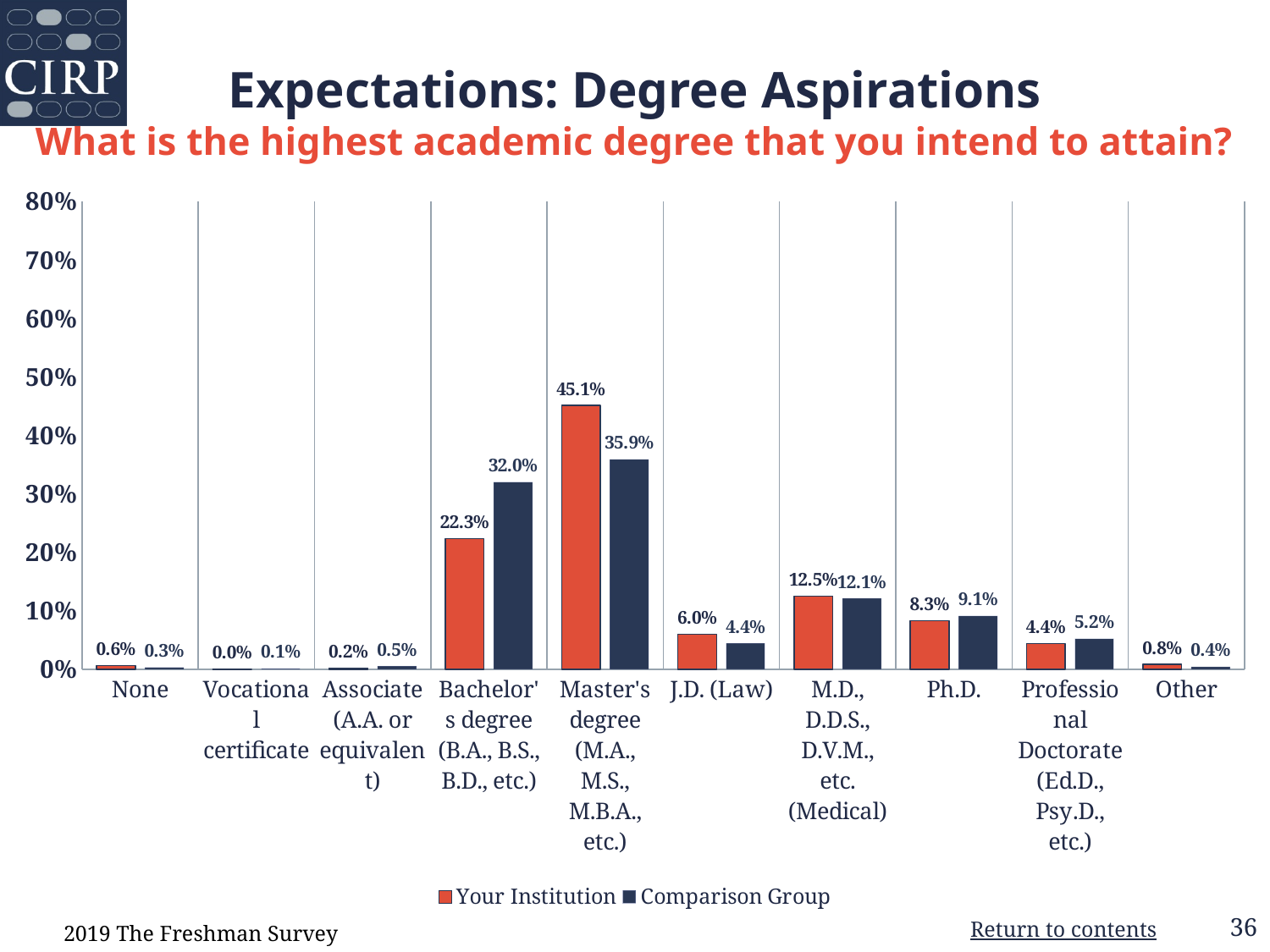
Which is larger for J.D. (Law): Your Institution or Comparison Group? Your Institution How many categories are shown on the x axis? 10 How many series does the legend list? 2 What kind of chart is shown on the slide? Bar chart Which is larger for Professional Doctorate: Your Institution or Comparison Group? Comparison Group What is the value for Your Institution for Master's degree? 45.1% What is the difference between Comparison Group and Your Institution for Bachelor's degree? 9.7% What is the difference between Your Institution and Comparison Group for Master's degree? 9.2% What is the value for Comparison Group for Bachelor's degree? 32.0% Which category has the lowest value for Your Institution? Vocational certificate What is the value for Your Institution for Ph.D.? 8.3% Which category has the highest value for Your Institution? Master's degree